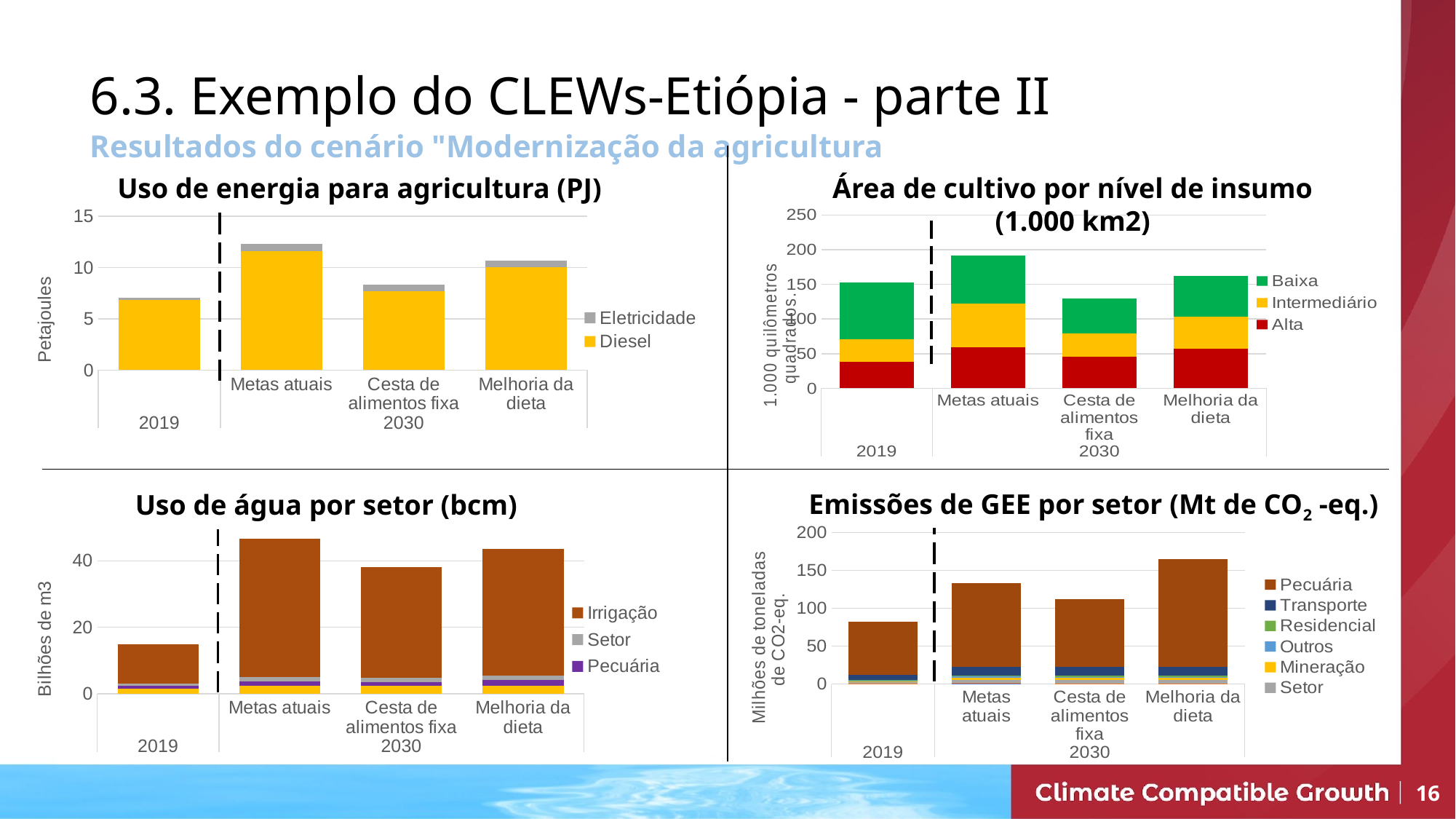
In the chart 'Uso de água por setor (bcm)', which category has the lowest total bar? 2019 In the chart 'Uso de energia para agricultura (PJ)', how many series does the legend list? 2 In the chart 'Uso de energia para agricultura (PJ)', which total bar is larger: Cesta de alimentos fixa or Melhoria da dieta? Melhoria da dieta In the chart 'Área de cultivo por nível de insumo (1.000 km2)', is the total for Metas atuais greater or less than 150? greater In the chart 'Área de cultivo por nível de insumo (1.000 km2)', how many series does the legend list? 3 In the chart 'Uso de energia para agricultura (PJ)', which category has the highest total bar? Metas atuais In the chart 'Uso de água por setor (bcm)', which total bar is larger: Metas atuais or Cesta de alimentos fixa? Metas atuais In the chart 'Uso de energia para agricultura (PJ)', is the total for 2019 greater or less than 10? less In the chart 'Área de cultivo por nível de insumo (1.000 km2)', which category has the lowest total bar? Cesta de alimentos fixa What kind of chart is 'Uso de água por setor (bcm)'? Stacked bar chart In the chart 'Emissões de GEE por setor (Mt de CO2 -eq.)', which category has the highest total bar? Melhoria da dieta In the chart 'Emissões de GEE por setor (Mt de CO2 -eq.)', how many series does the legend list? 6